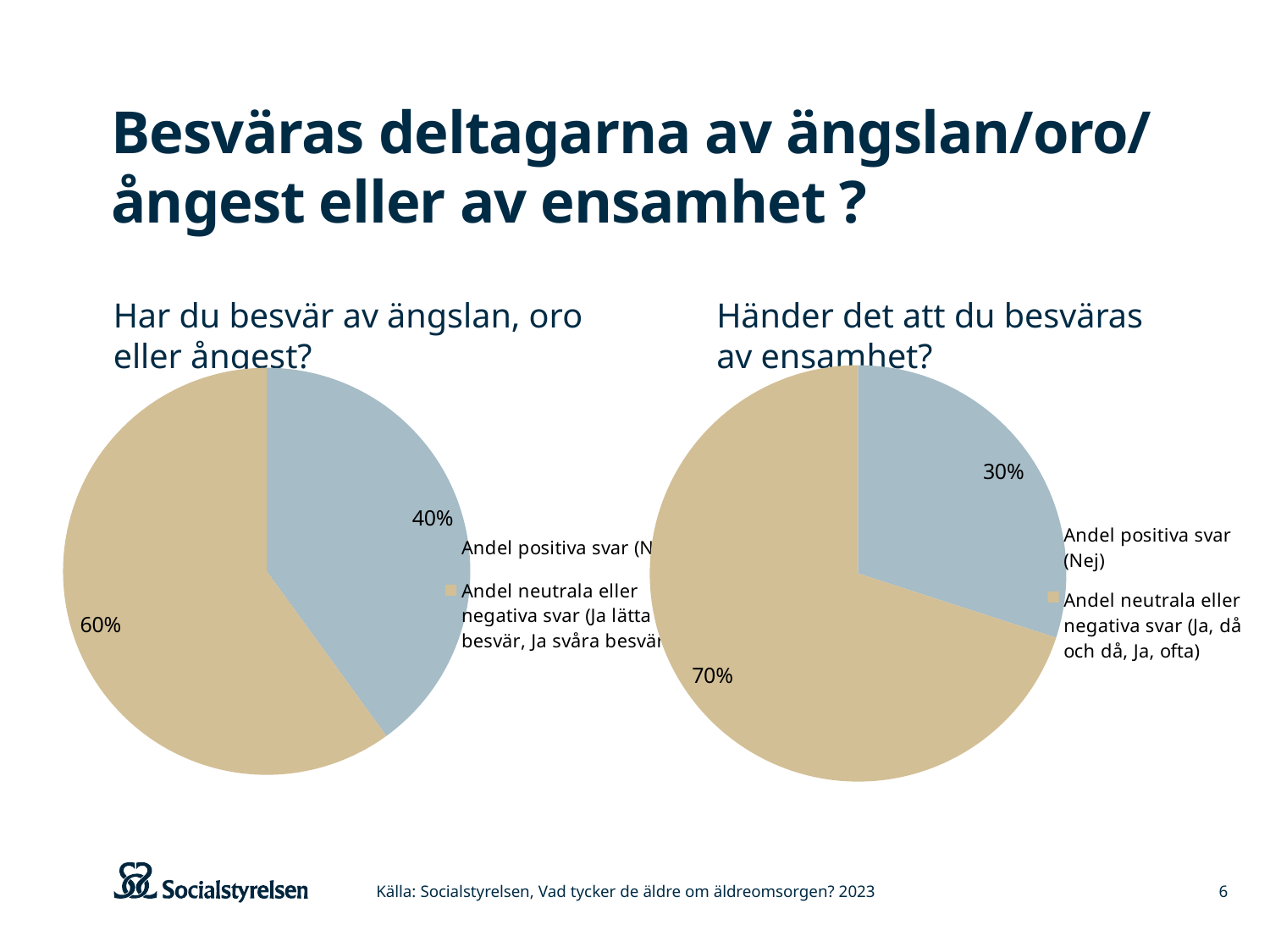
In the chart "Har du besvär av ängslan, oro eller ångest?", what share is labelled for the positive answers (Andel positiva svar)? 40% Which chart has the larger share of positive answers: "Har du besvär av ängslan, oro eller ångest?" or "Händer det att du besväras av ensamhet?"? Har du besvär av ängslan, oro eller ångest? In the chart "Har du besvär av ängslan, oro eller ångest?", what share is labelled for neutral or negative answers (Andel neutrala eller negativa svar)? 60% In the chart "Händer det att du besväras av ensamhet?", what colour is the slice for "Andel positiva svar (Nej)"? Blue-grey How many slices does the chart "Händer det att du besväras av ensamhet?" have? 2 In the chart "Händer det att du besväras av ensamhet?", what is the difference in percentage points between the 70% slice and the 30% slice? 40 percentage points In the chart "Händer det att du besväras av ensamhet?", which slice is the largest? Andel neutrala eller negativa svar (Ja, då och då, Ja, ofta) What kind of chart is used for "Har du besvär av ängslan, oro eller ångest?"? Pie chart In the chart "Händer det att du besväras av ensamhet?", what share is labelled for "Andel positiva svar (Nej)"? 30% In the chart "Har du besvär av ängslan, oro eller ångest?", what is the difference in percentage points between the neutral/negative slice and the positive slice? 20 percentage points In the chart "Har du besvär av ängslan, oro eller ångest?", which slice is the smallest? Andel positiva svar In the chart "Händer det att du besväras av ensamhet?", what share is labelled for "Andel neutrala eller negativa svar (Ja, då och då, Ja, ofta)"? 70%